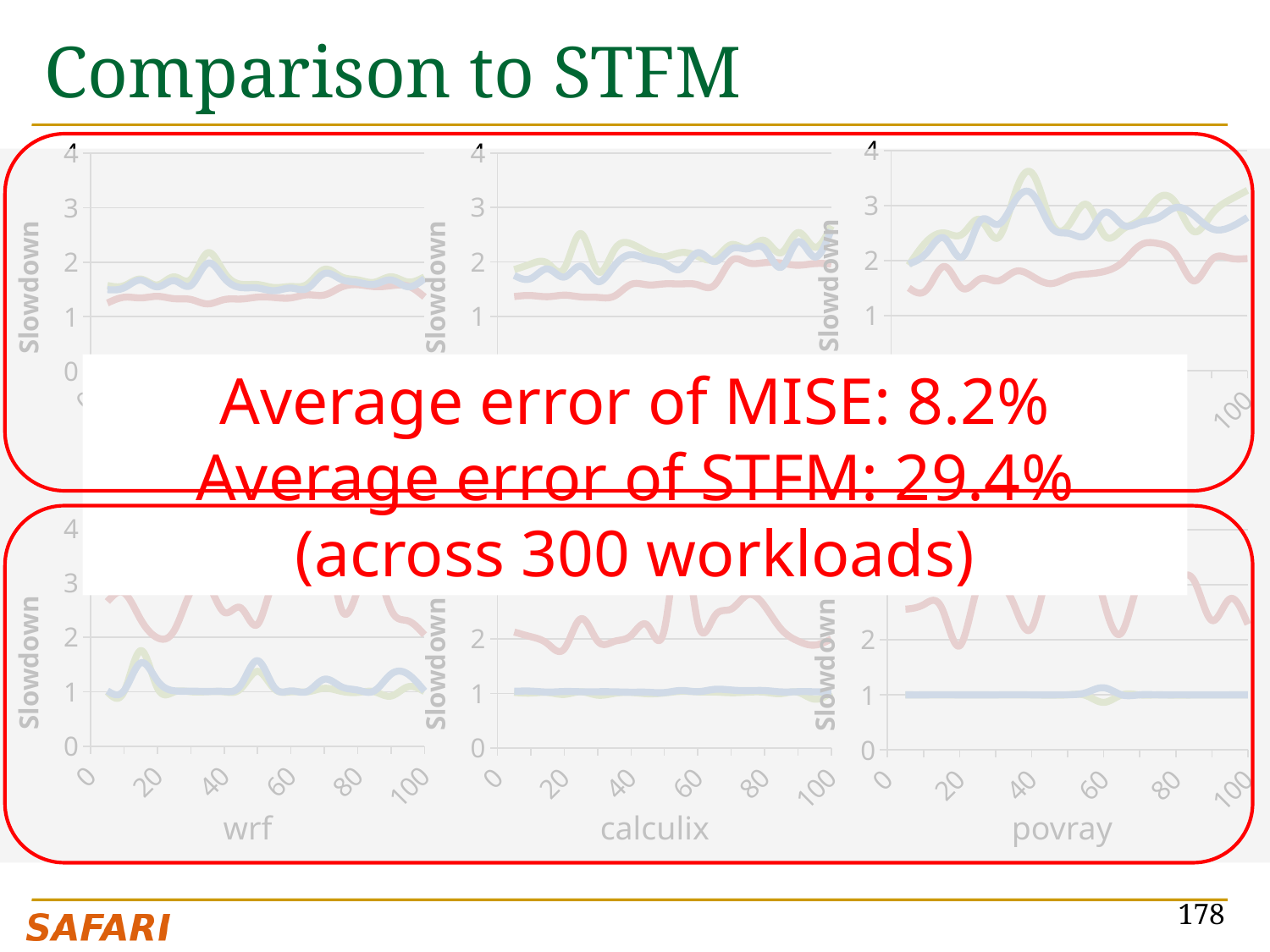
In the top-right chart, is the green line's value at x = 40 greater or less than 3? greater In the bottom-middle (calculix) chart, is the blue line's value at x = 60 greater or less than 2? less What is the largest x-axis tick value shown on the bottom-right (povray) chart? 100 What is the y-axis label on the chart panels? Slowdown How many lines are plotted in each chart panel? 3 What kind of chart is used in the bottom-left panel labelled wrf? line chart In the bottom-right (povray) chart, is the blue line's value at x = 40 greater or less than 2? less How many chart panels are shown on the slide? 6 What is the x-axis label of the bottom-middle chart panel? calculix What is the x-axis label of the bottom-right chart panel? povray What is the highest tick value shown on the y-axis of the bottom-left (wrf) chart? 4